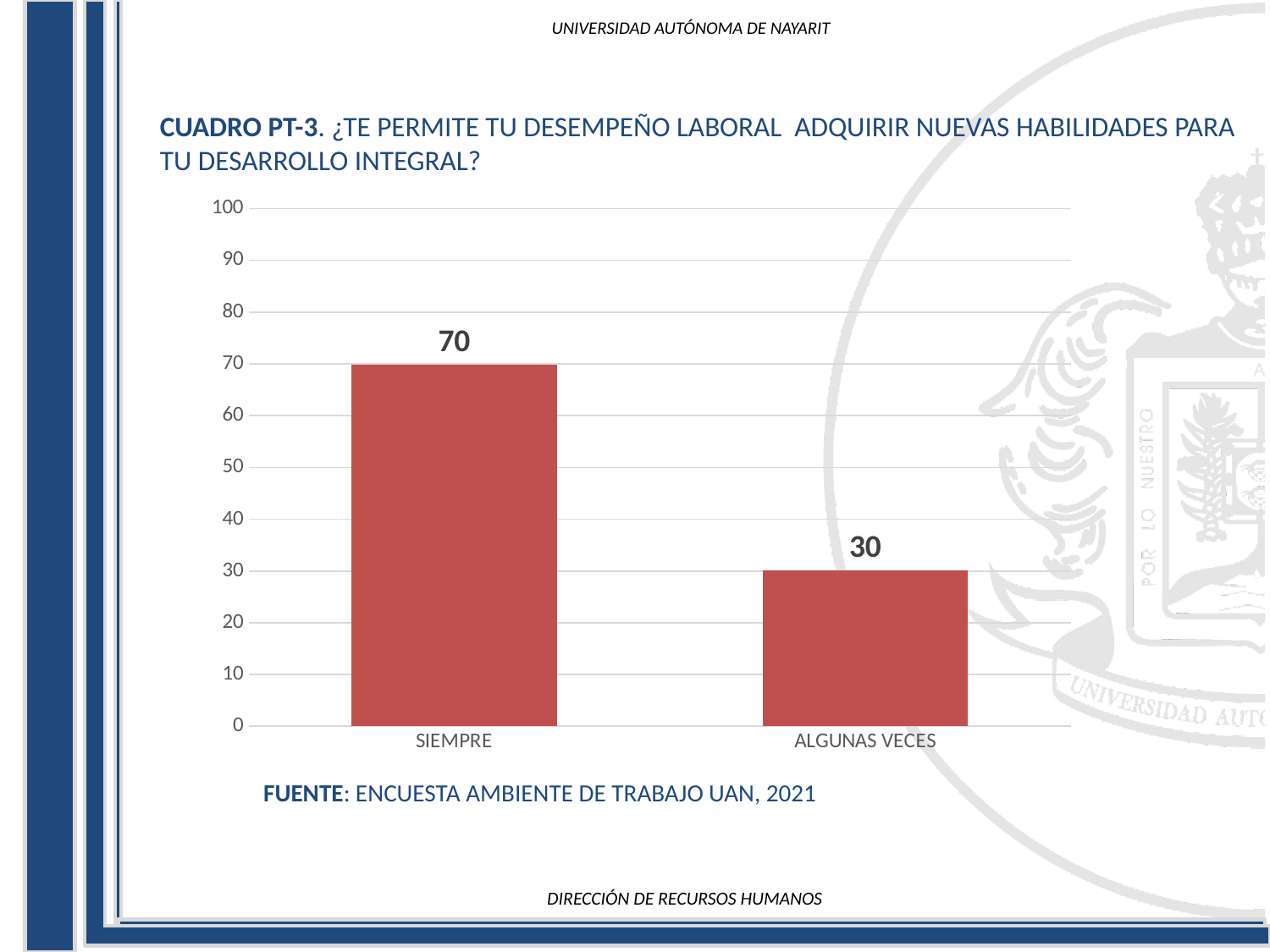
Is the value for SIEMPRE greater or less than 50? greater What is the source cited below the chart? ENCUESTA AMBIENTE DE TRABAJO UAN, 2021 How many categories are shown on the x axis? 2 Which category has the highest value? SIEMPRE What kind of chart is shown on the slide? bar chart What is the difference between the values for SIEMPRE and ALGUNAS VECES? 40 Which category has the lowest value? ALGUNAS VECES What is the value for SIEMPRE? 70 Which is larger, the value for SIEMPRE or the value for ALGUNAS VECES? SIEMPRE What is the total of the two bar values? 100 Is the value for ALGUNAS VECES greater or less than 40? less What is the value for ALGUNAS VECES? 30